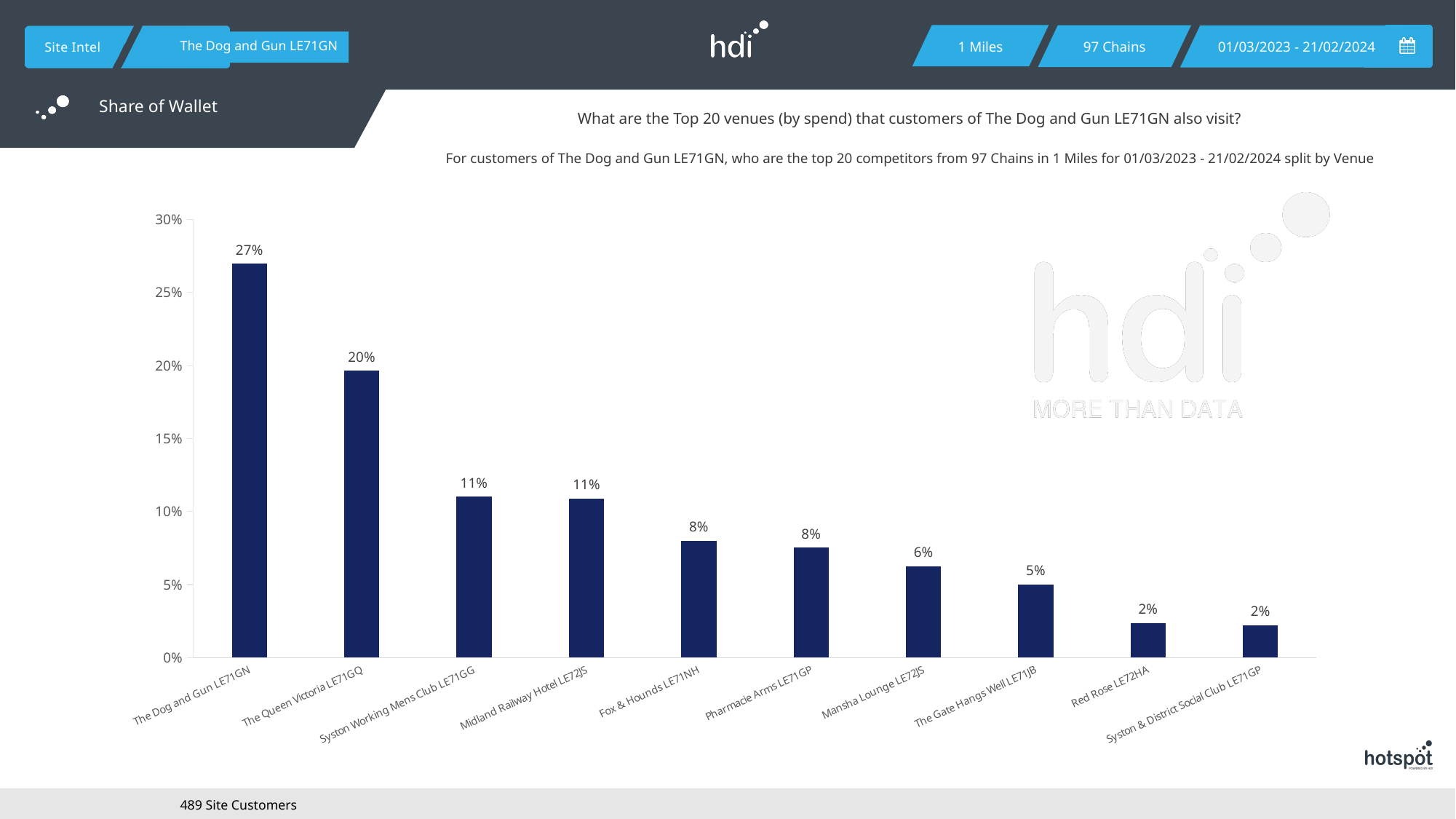
What is the value for The Gate Hangs Well LE71JB? 5% How many site customers are stated at the bottom of the slide? 489 Site Customers What is the value for Mansha Lounge LE72JS? 6% What is the difference between the values for The Dog and Gun LE71GN and The Queen Victoria LE71GQ? 7% What is the value for The Queen Victoria LE71GQ? 20% Is the value for Pharmacie Arms LE71GP greater or less than 10%? less What kind of chart is shown on the slide? bar chart Do the values rise or fall from left to right across the chart? fall How many venues are shown in the chart? 10 Which venue has the highest share of wallet? The Dog and Gun LE71GN What is the value for Fox & Hounds LE71NH? 8% Which is larger: the value for The Queen Victoria LE71GQ or Syston Working Mens Club LE71GG? The Queen Victoria LE71GQ